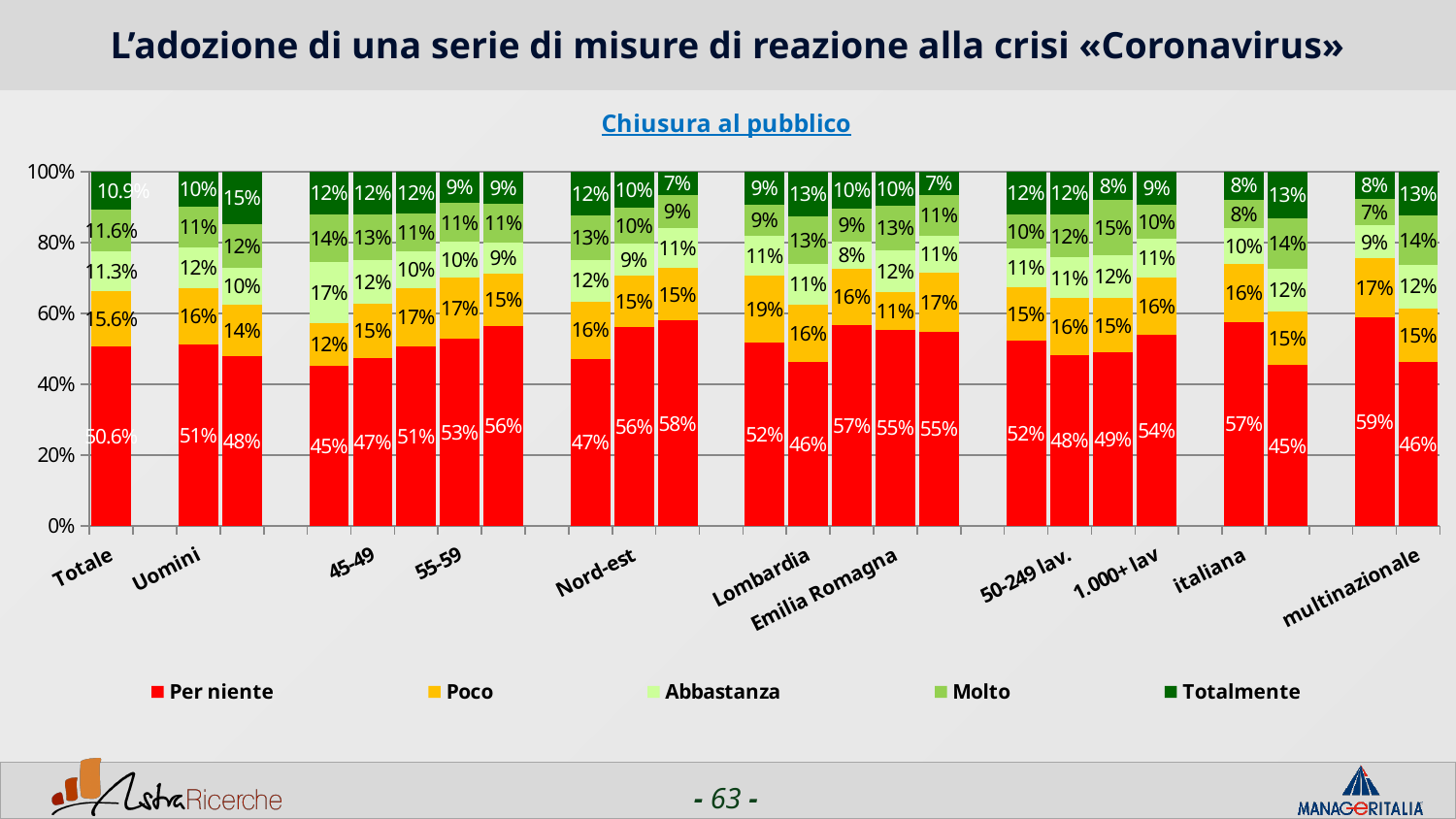
What is the difference between the 'Per niente' values for Nord-est and Lombardia? 10 percentage points What is the 'Per niente' value for Emilia Romagna? 55% How many series does the legend list? 5 What is the 'Per niente' value for Lombardia? 46% What kind of chart is shown on the slide? Stacked bar chart Which has the larger 'Per niente' value, Uomini or Lombardia? Uomini What is the 'Per niente' value for multinazionale? 46% What is the 'Poco' value for Lombardia? 16% What is the 'Per niente' value for Uomini? 51% What is the subtitle shown above the chart? Chiusura al pubblico What is the 'Per niente' value for Totale? 50.6% What is the 'Totalmente' value for Totale? 10.9%